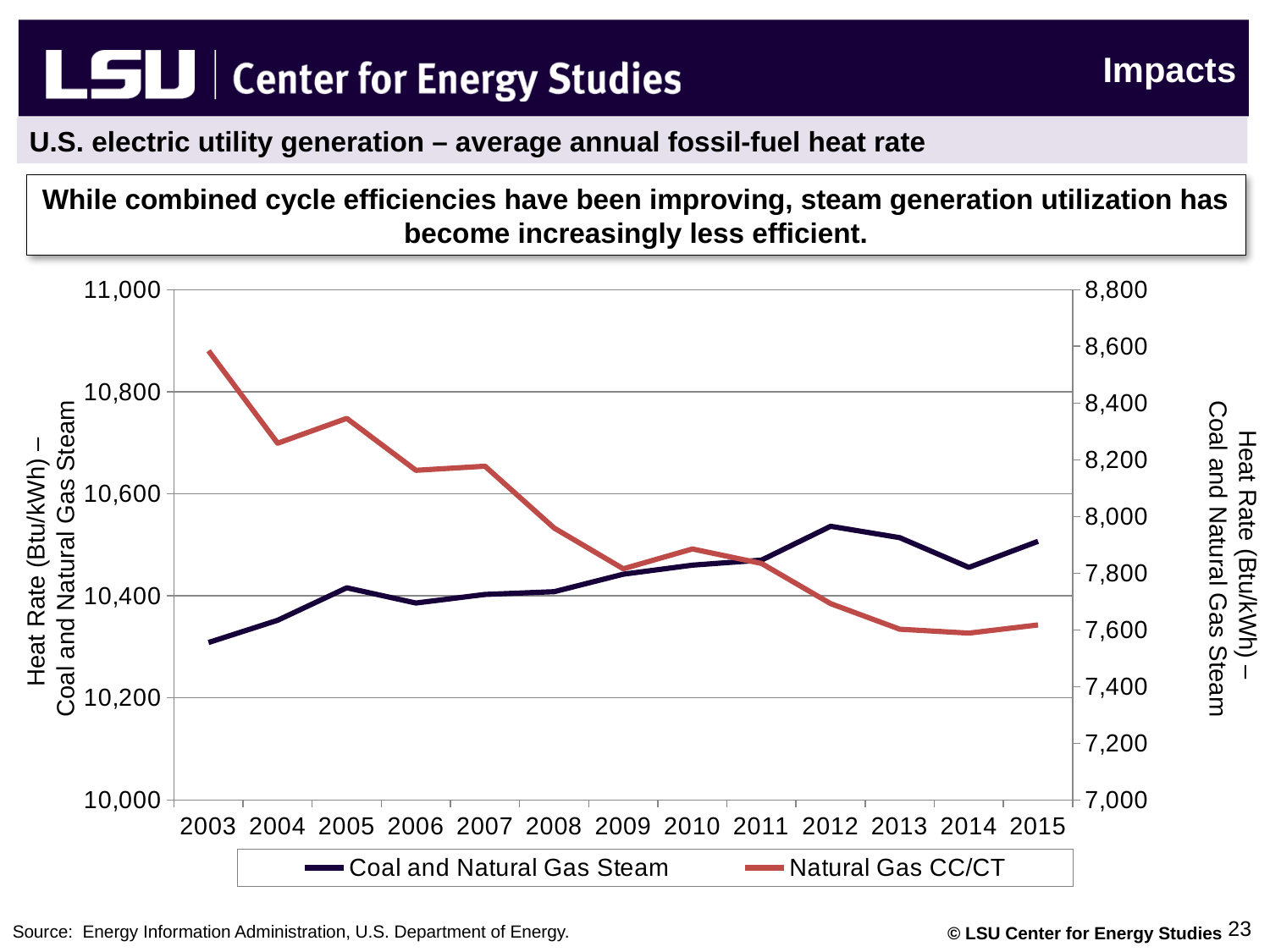
How many years are plotted along the x axis? 13 Is the Natural Gas CC/CT value for 2014 greater or less than 7,800 on the right axis? less In which year is the Coal and Natural Gas Steam heat rate highest? 2012 Is the Coal and Natural Gas Steam value for 2003 greater or less than 10,400? less Is the Natural Gas CC/CT value for 2003 greater or less than 8,400 on the right axis? greater In which year is the Natural Gas CC/CT heat rate highest? 2003 How many series does the legend list? 2 What is the title of the chart? U.S. electric utility generation – average annual fossil-fuel heat rate What kind of chart is shown on the slide? line chart Does the Natural Gas CC/CT heat rate generally rise or fall from 2003 to 2015? fall Which series is shown in red? Natural Gas CC/CT In which year is the Coal and Natural Gas Steam heat rate lowest? 2003